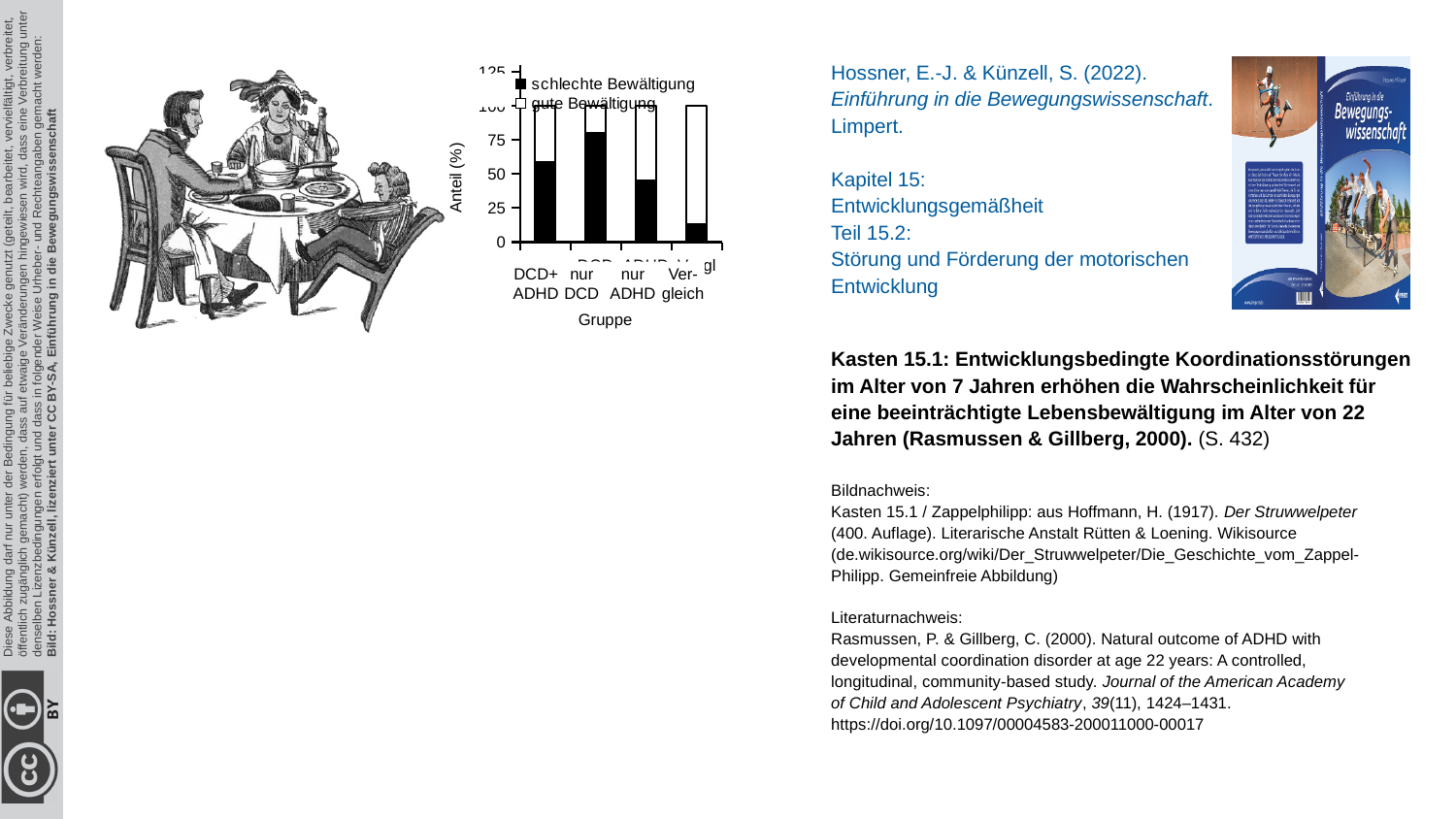
How many groups are shown on the x axis of the chart? 4 What kind of chart is shown on the slide? stacked bar chart Which group has the highest share of gute Bewältigung? Vergleich Which group has a larger share of schlechte Bewältigung, nur DCD or Vergleich? nur DCD What are the two legend entries of the chart? schlechte Bewältigung, gute Bewältigung Which group has a larger share of schlechte Bewältigung, DCD+ADHD or nur ADHD? DCD+ADHD Is the share of schlechte Bewältigung for Vergleich greater or less than 25? less Which group has the lowest share of schlechte Bewältigung? Vergleich How many series does the chart legend list? 2 What is the label of the y axis of the chart? Anteil (%) Is the share of schlechte Bewältigung for DCD+ADHD greater or less than 50? greater Which group has the highest share of schlechte Bewältigung? nur DCD